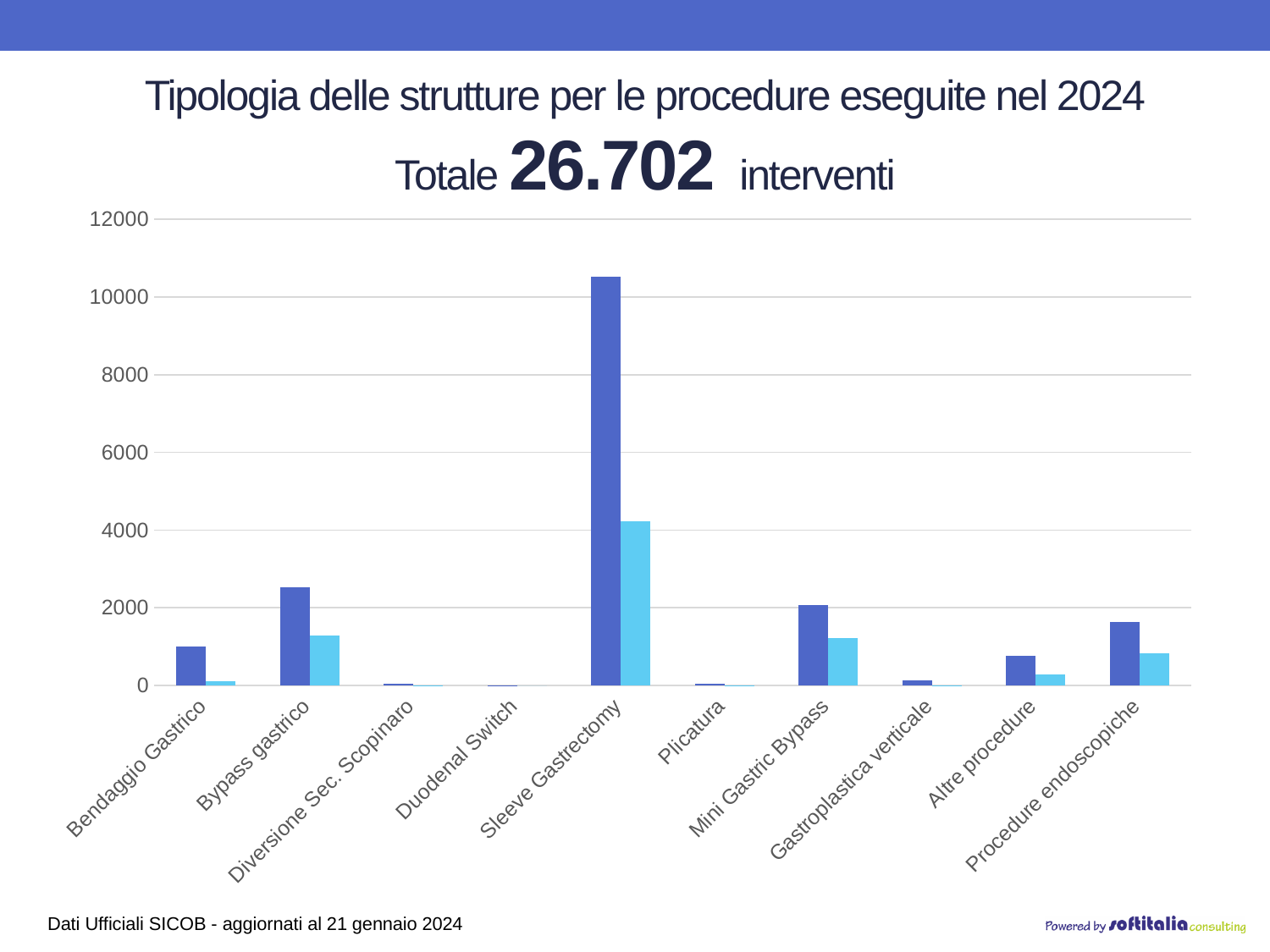
Which has the taller dark blue bar, Sleeve Gastrectomy or Bypass gastrico? Sleeve Gastrectomy Which has the taller dark blue bar, Bypass gastrico or Mini Gastric Bypass? Bypass gastrico How many procedure categories are shown on the x axis of the chart? 10 Is the dark blue bar for Sleeve Gastrectomy greater or less than 10000? greater What is the title of the chart? Tipologia delle strutture per le procedure eseguite nel 2024 Which procedure category has the tallest bar in the chart? Sleeve Gastrectomy What kind of chart is shown on the slide? bar chart Is the dark blue bar for Bypass gastrico greater or less than 2000? greater Is the dark blue bar for Procedure endoscopiche greater or less than 2000? less What total number of interventions is stated in the chart title? 26.702